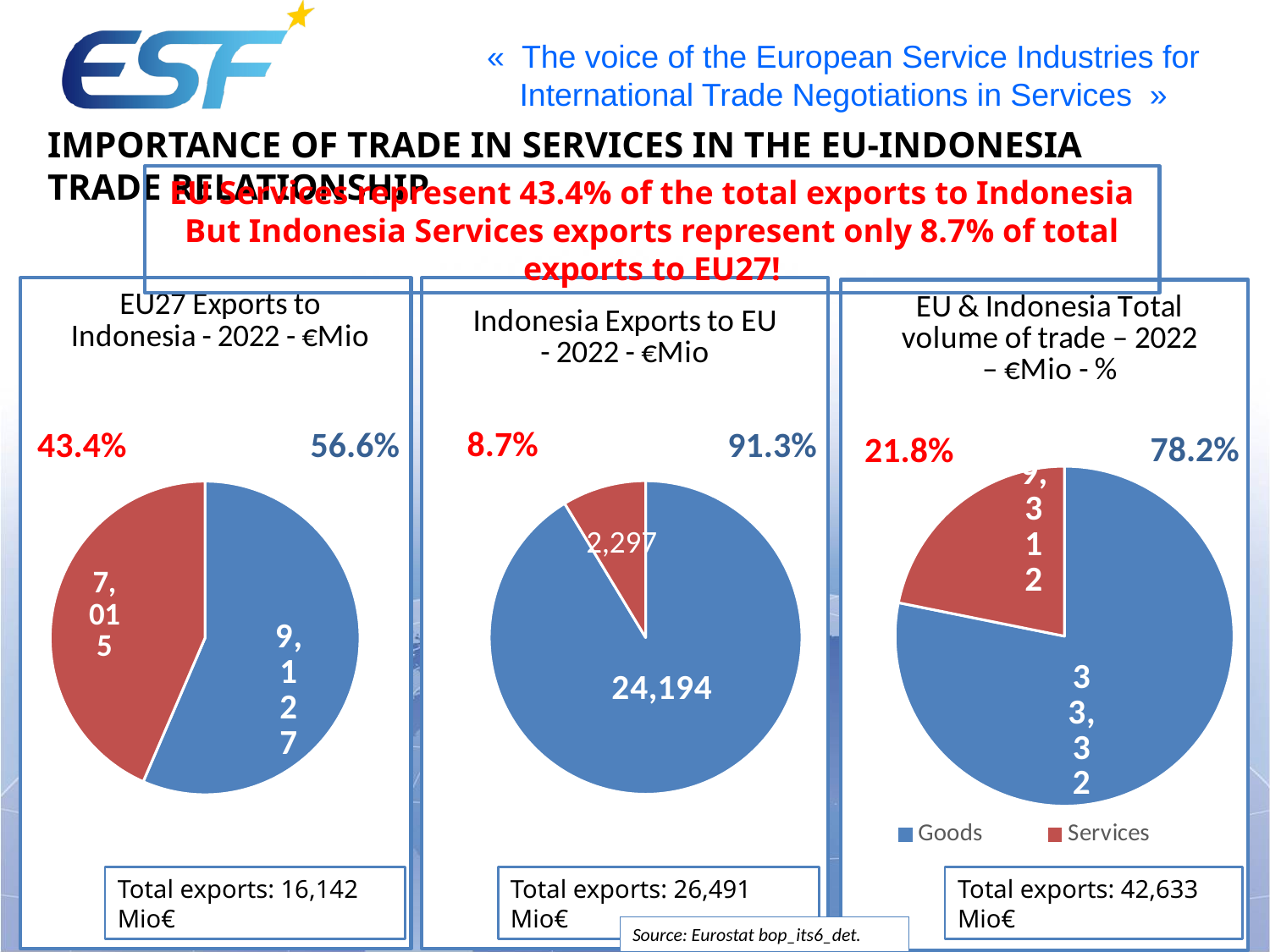
In the 'Indonesia Exports to EU - 2022 - €Mio' chart, what is the difference between the Goods and Services values? 21,897 In the 'EU27 Exports to Indonesia - 2022 - €Mio' chart, what is the value of the Services slice? 7,015 Which colour represents Services in the pie charts? Red In the 'EU27 Exports to Indonesia - 2022 - €Mio' chart, what is the value of the Goods slice? 9,127 How many series does the legend on the 'EU & Indonesia Total volume of trade – 2022' chart list? 2 In the 'Indonesia Exports to EU - 2022 - €Mio' chart, what share of the pie is Goods? 91.3% In the 'Indonesia Exports to EU - 2022 - €Mio' chart, what is the value of the Goods slice? 24,194 In the 'EU & Indonesia Total volume of trade – 2022' chart, what share of the pie is Services? 21.8% What kind of charts are shown on the slide? Pie charts In the 'Indonesia Exports to EU - 2022 - €Mio' chart, what is the value of the Services slice? 2,297 In the 'EU27 Exports to Indonesia - 2022 - €Mio' chart, what share of the pie is Services? 43.4% In the 'EU & Indonesia Total volume of trade – 2022' chart, which slice is larger, Goods or Services? Goods